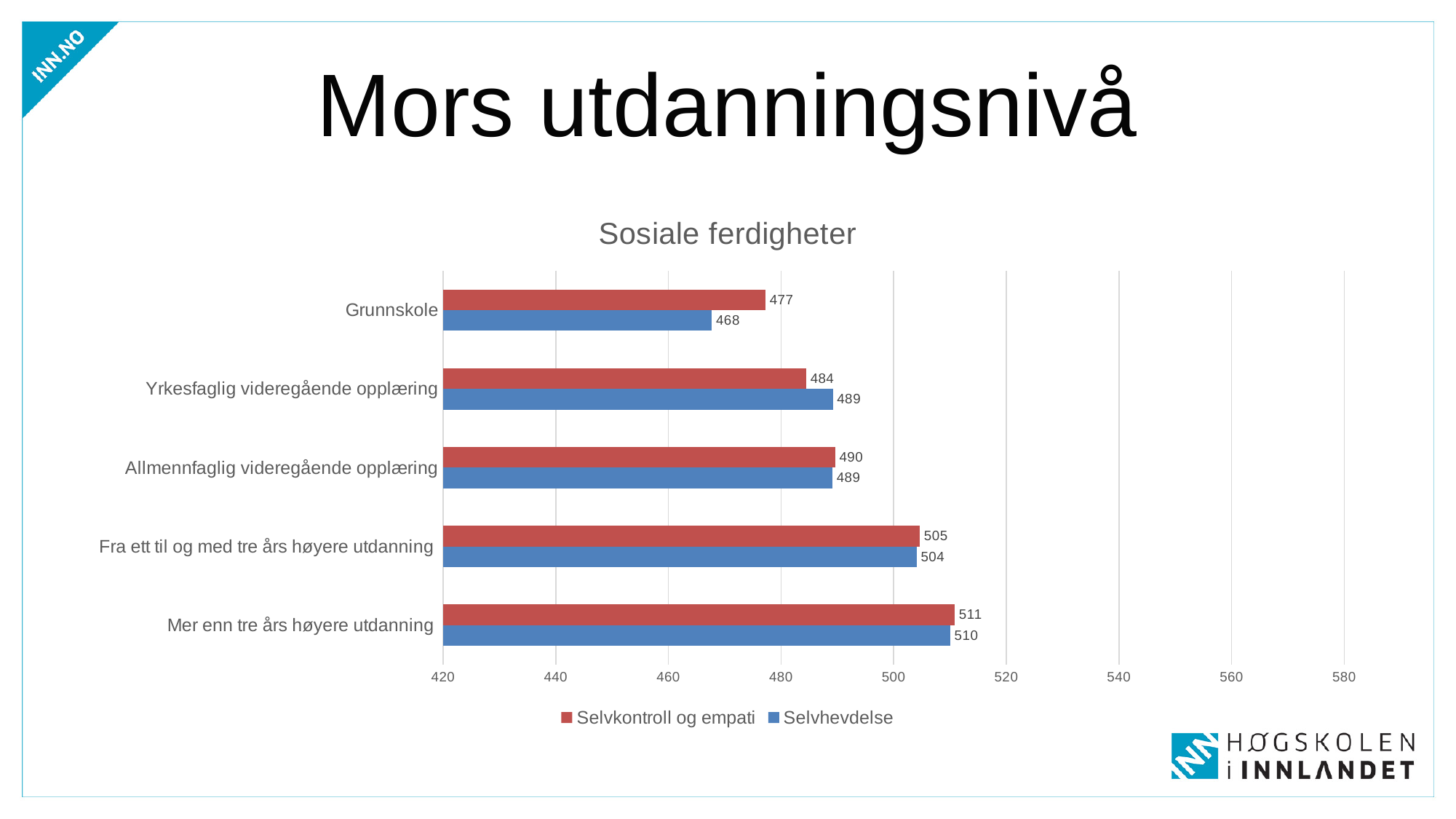
What is the Selvkontroll og empati value for Grunnskole? 477 What kind of chart is shown on the slide? Bar chart What is the Selvhevdelse value for Yrkesfaglig videregående opplæring? 489 Is the Selvhevdelse value for Fra ett til og med tre års høyere utdanning greater or less than 500? greater What is the Selvhevdelse value for Mer enn tre års høyere utdanning? 510 How many series does the legend list? 2 Which category has the lowest Selvhevdelse value? Grunnskole How many categories are shown on the chart? 5 What is the difference between the Selvkontroll og empati and Selvhevdelse values for Grunnskole? 9 Which category has the highest Selvkontroll og empati value? Mer enn tre års høyere utdanning Which is larger for Yrkesfaglig videregående opplæring: Selvkontroll og empati or Selvhevdelse? Selvhevdelse What is the title of the chart? Sosiale ferdigheter